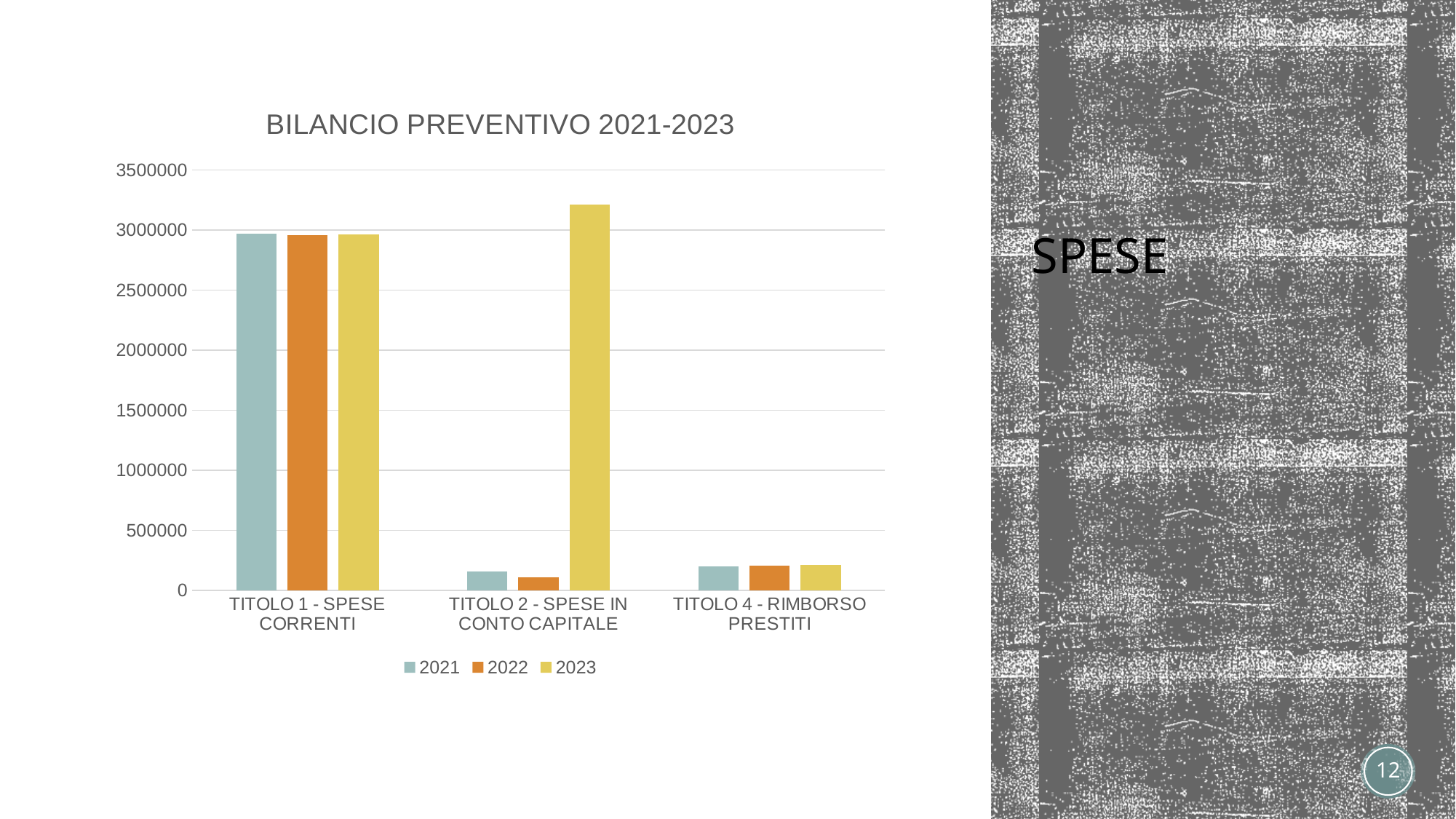
Is the 2021 value for TITOLO 1 - SPESE CORRENTI greater or less than 2500000? greater Is the 2023 value for TITOLO 4 - RIMBORSO PRESTITI greater or less than 500000? less What kind of chart is shown on the slide? bar chart For the 2023 series, which is larger: TITOLO 1 - SPESE CORRENTI or TITOLO 2 - SPESE IN CONTO CAPITALE? TITOLO 2 - SPESE IN CONTO CAPITALE Is the 2023 value for TITOLO 2 - SPESE IN CONTO CAPITALE greater or less than 3000000? greater Which category has the tallest bar for the 2023 series? TITOLO 2 - SPESE IN CONTO CAPITALE For the 2021 series, which is larger: TITOLO 2 - SPESE IN CONTO CAPITALE or TITOLO 4 - RIMBORSO PRESTITI? TITOLO 4 - RIMBORSO PRESTITI How many categories are shown on the x axis? 3 How many series does the legend list? 3 Which series is shown in orange in the legend? 2022 What is the title of the chart? BILANCIO PREVENTIVO 2021-2023 Which series has the lowest value for TITOLO 2 - SPESE IN CONTO CAPITALE? 2022